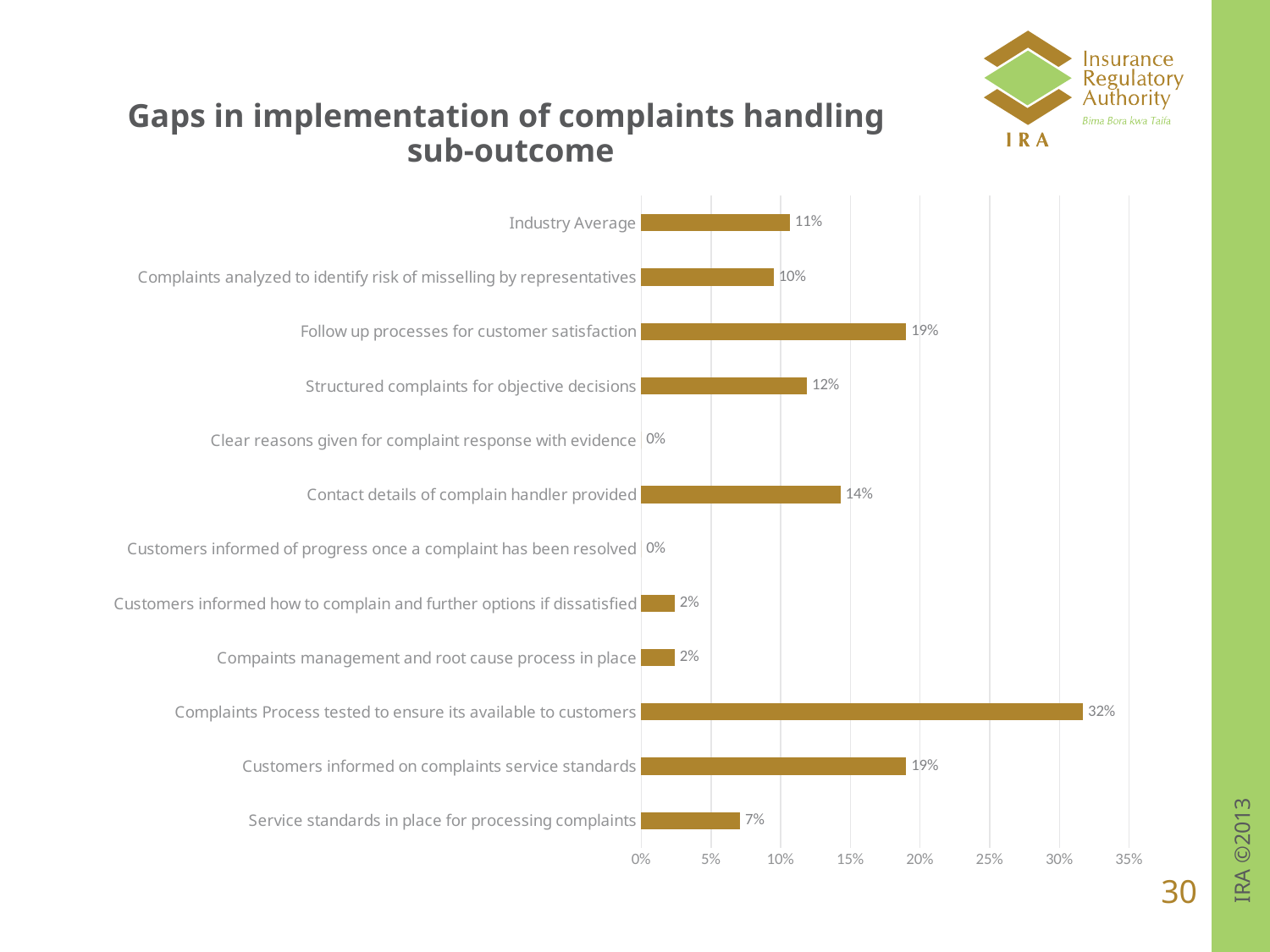
Which category has the highest value? Complaints Process tested to ensure its available to customers What is the value for Contact details of complain handler provided? 14% Which is larger: Complaints analyzed to identify risk of misselling by representatives or Contact details of complain handler provided? Contact details of complain handler provided How many categories are shown on the chart? 12 How many categories have a value of 0%? 2 What is the value for Complaints Process tested to ensure its available to customers? 32% What is the difference between Complaints Process tested to ensure its available to customers and Industry Average? 21% What is the difference between Follow up processes for customer satisfaction and Structured complaints for objective decisions? 7% What is the title of the slide containing the chart? Gaps in implementation of complaints handling sub-outcome What kind of chart is shown on the slide? Bar chart What is the value for Service standards in place for processing complaints? 7% What is the value for Industry Average? 11%